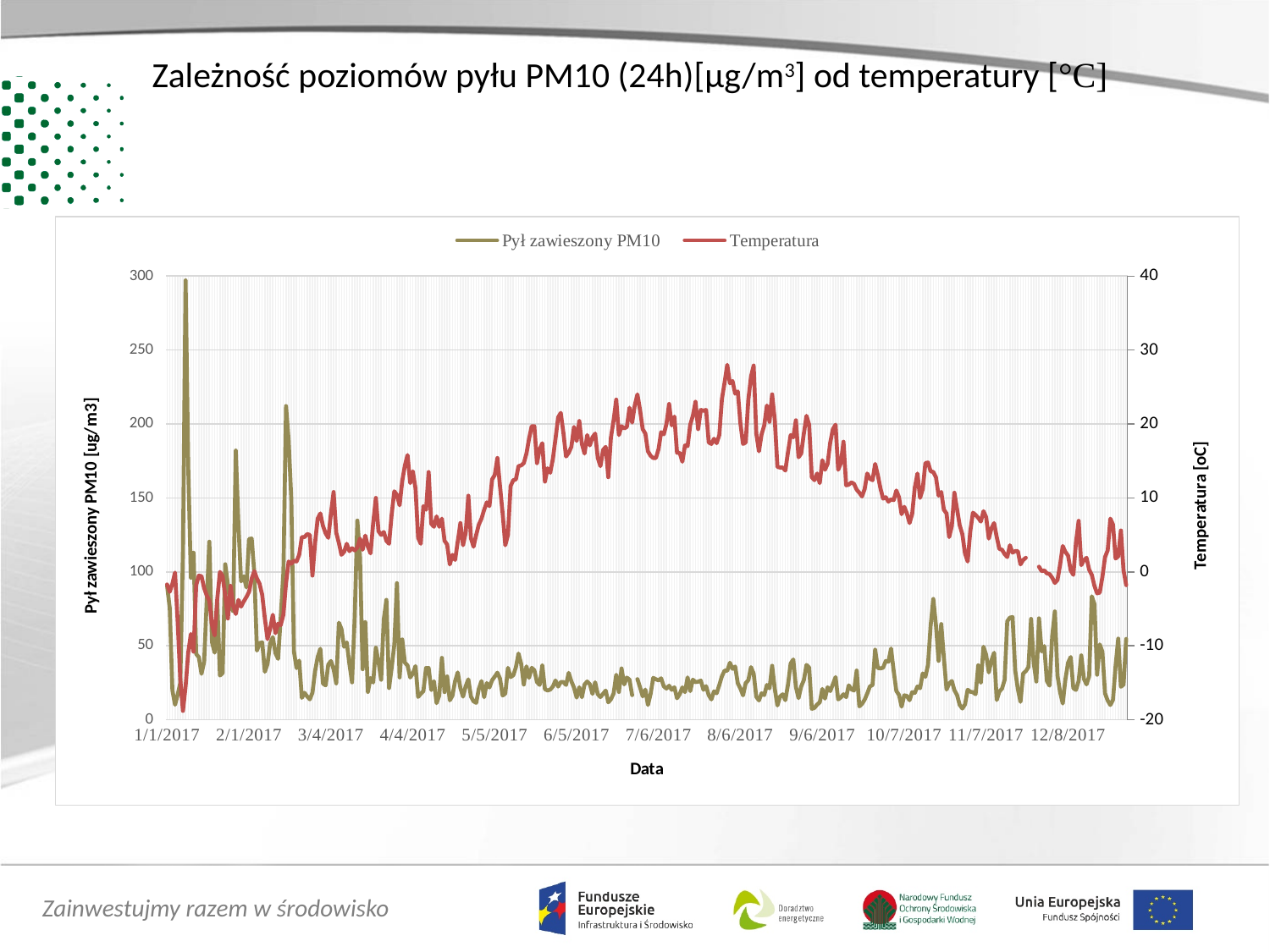
How many series does the chart legend list? 2 Does the Temperatura series generally rise or fall between 1/1/2017 and 8/6/2017? rise In which month does the Pył zawieszony PM10 series reach its highest peak? January 2017 What are the two series named in the chart legend? Pył zawieszony PM10 and Temperatura Is the highest peak of the Pył zawieszony PM10 series greater or less than 250 on the left axis? greater Is the highest value of the Temperatura series, reached around 8/6/2017, greater or less than 20 on the right axis? greater What kind of chart is shown on the slide? line chart Around 7/6/2017, which series is plotted higher on the chart, Pył zawieszony PM10 or Temperatura? Temperatura What is the title of the left vertical axis of the chart? Pył zawieszony PM10 [ug/m3] Is the Temperatura value at the start of the chart (1/1/2017) greater or less than 10 on the right axis? less How many date labels are shown along the x axis of the chart? 12 Does the Temperatura series generally rise or fall between 8/6/2017 and 12/8/2017? fall